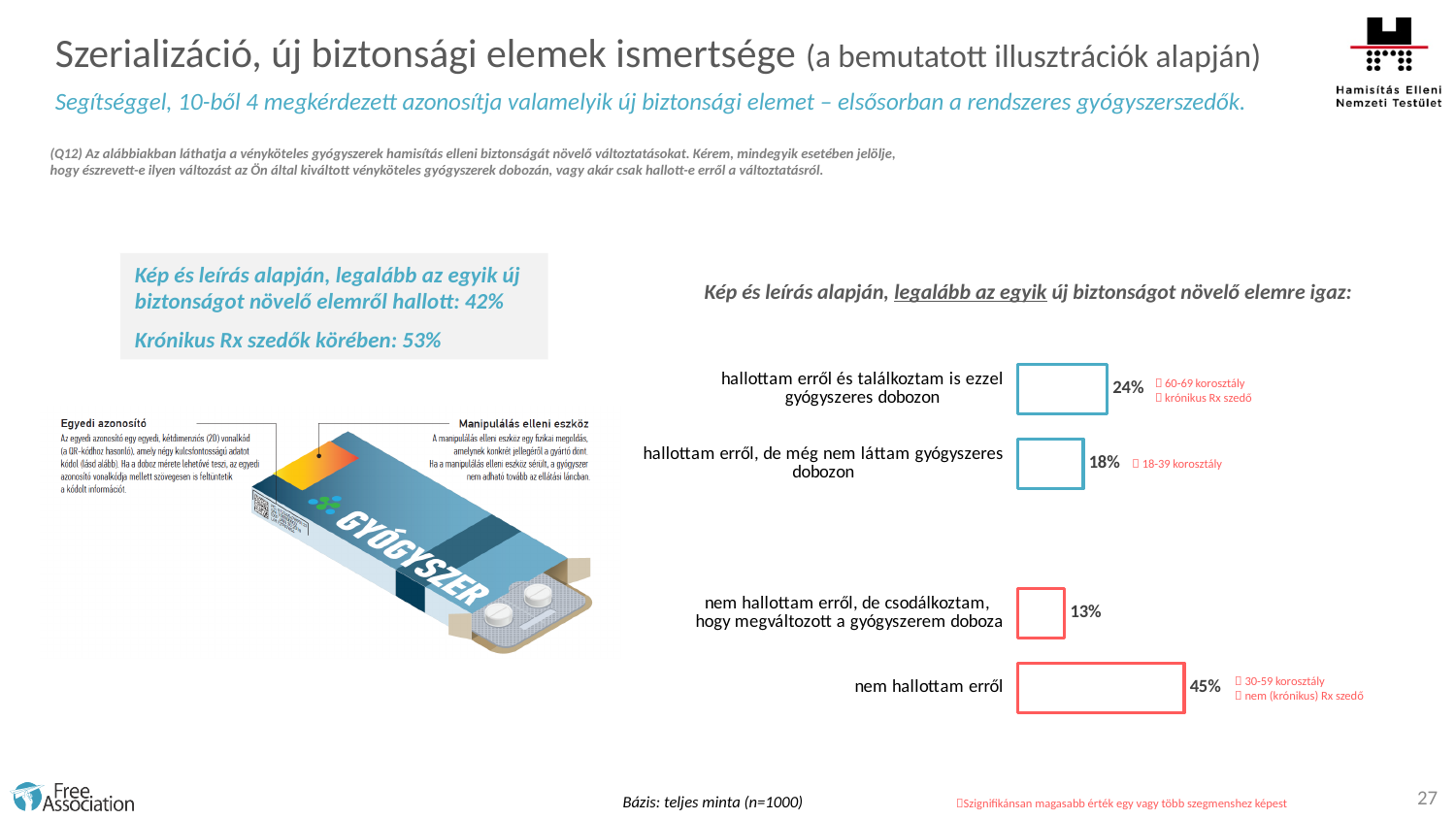
What is the difference between the values for "hallottam erről, de még nem láttam gyógyszeres dobozon" and "nem hallottam erről, de csodálkoztam, hogy megváltozott a gyógyszerem doboza"? 5% What is the difference between the values for "nem hallottam erről" and "hallottam erről és találkoztam is ezzel gyógyszeres dobozon"? 21% What is the value for "hallottam erről, de még nem láttam gyógyszeres dobozon"? 18% Which category has the lowest value? nem hallottam erről, de csodálkoztam, hogy megváltozott a gyógyszerem doboza What kind of chart is shown on the slide? bar chart How many categories does the chart show? 4 Which is larger: the value for "hallottam erről és találkoztam is ezzel gyógyszeres dobozon" or the value for "hallottam erről, de még nem láttam gyógyszeres dobozon"? hallottam erről és találkoztam is ezzel gyógyszeres dobozon What is the value for "nem hallottam erről"? 45% What is the value for "nem hallottam erről, de csodálkoztam, hogy megváltozott a gyógyszerem doboza"? 13% Which category has the highest value? nem hallottam erről What is the value for "hallottam erről és találkoztam is ezzel gyógyszeres dobozon"? 24% What is the title of the chart? Kép és leírás alapján, legalább az egyik új biztonságot növelő elemre igaz: